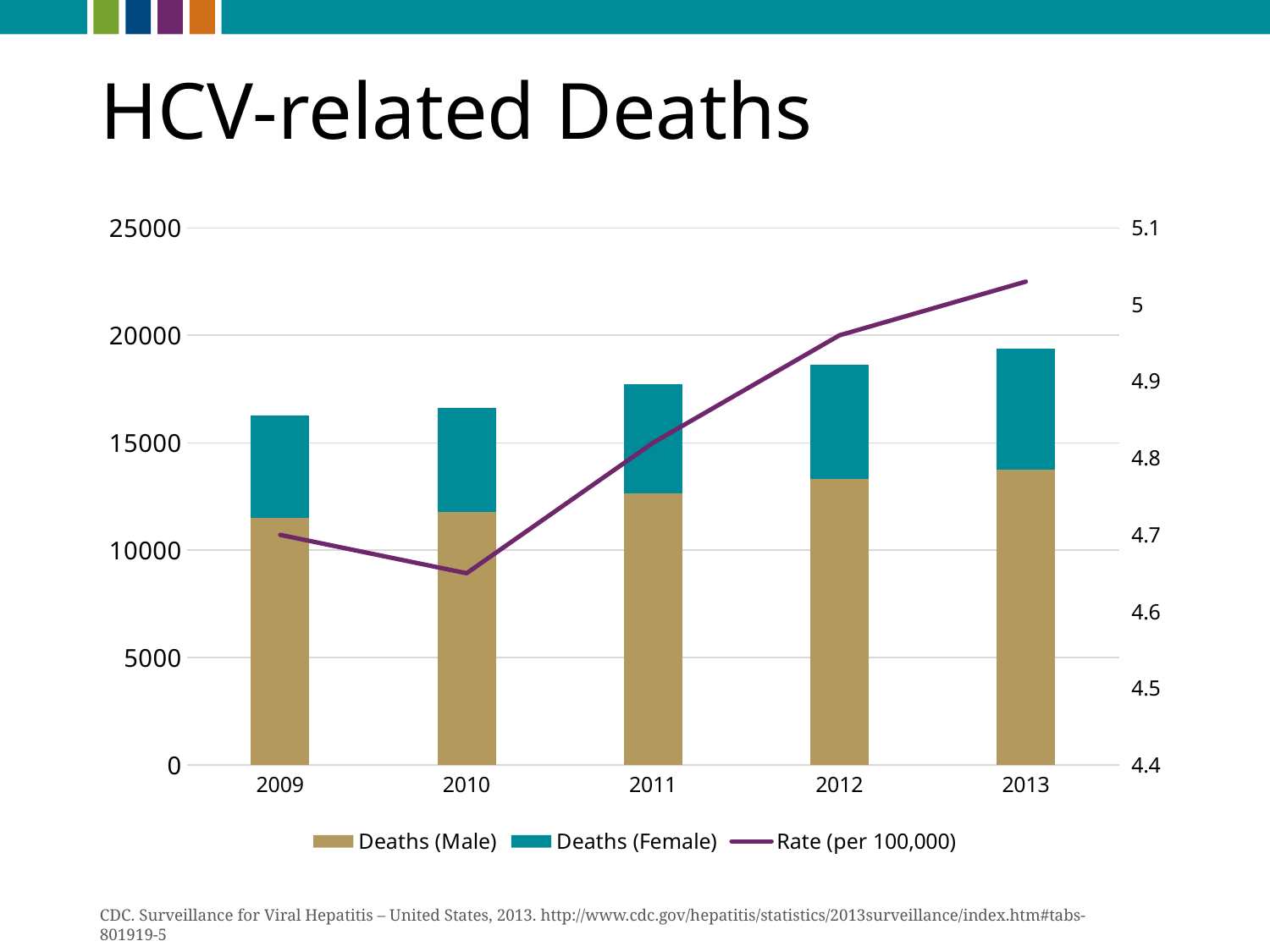
What kind of chart is shown on the slide? A stacked bar chart combined with a line chart In which year is the Rate (per 100,000) line at its lowest point? 2010 Is the total stacked bar for 2013 greater or less than 20000? less Is the total stacked bar for 2009 greater or less than 15000? greater Which is larger in 2013, Deaths (Male) or Deaths (Female)? Deaths (Male) From 2010 to 2013, does the Rate (per 100,000) line rise or fall? rise How many series does the legend list? 3 Which year has the shortest stacked bar for total deaths? 2009 How many years are shown on the x axis? 5 Which year has the tallest stacked bar for total deaths? 2013 Is the Rate (per 100,000) value for 2012 greater or less than 4.9? greater In which year is the Rate (per 100,000) line at its highest point? 2013